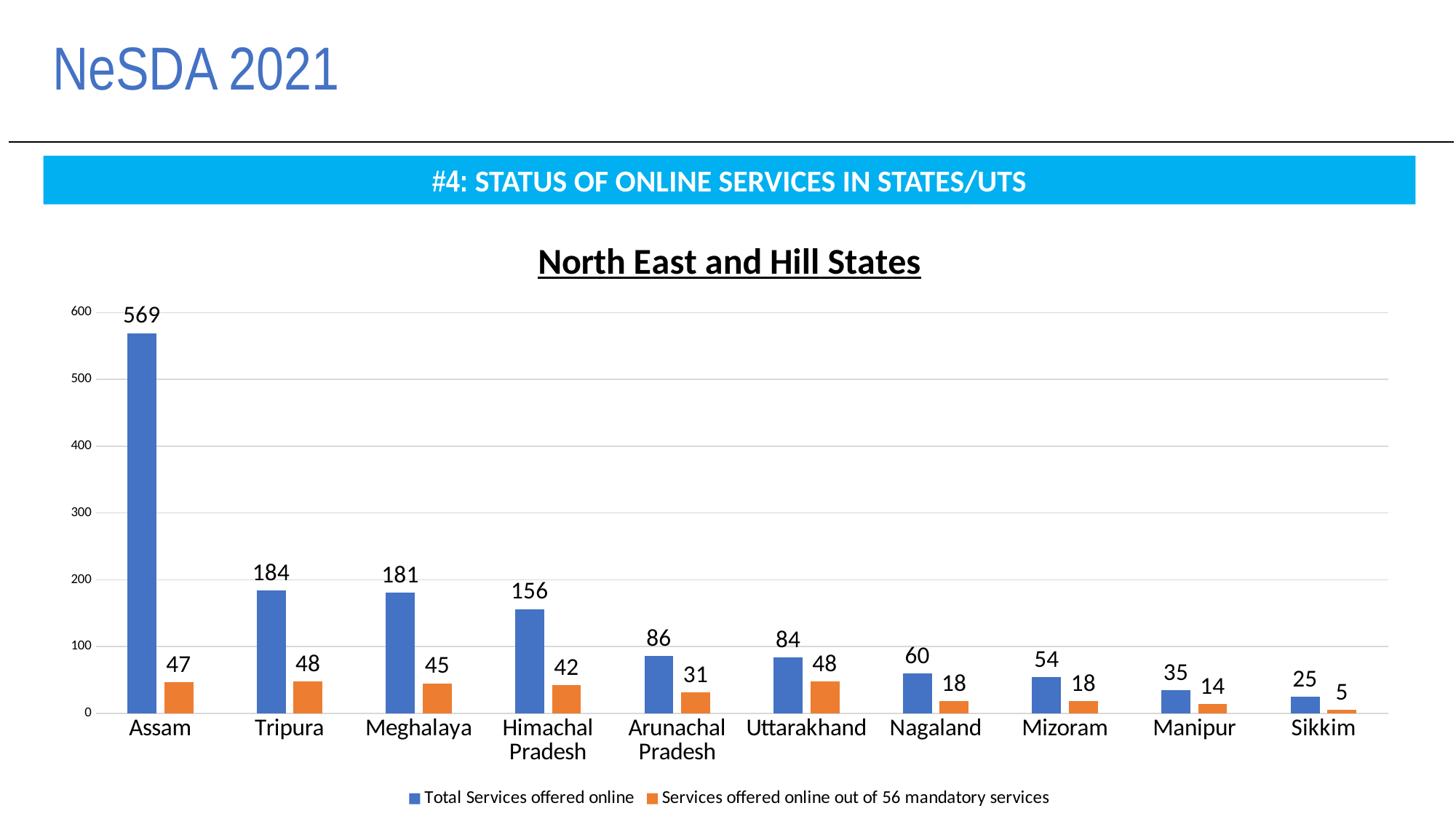
How many series does the legend list? 2 Which state has the lowest number of services offered online out of 56 mandatory services? Sikkim Is the value of Total Services offered online for Assam greater or less than 500? greater How many states are shown on the x axis of the chart? 10 Which state has the highest Total Services offered online? Assam What is the title of the chart? North East and Hill States What kind of chart is shown on the slide? Bar chart What is the value of Total Services offered online for Himachal Pradesh? 156 Which is larger: Total Services offered online for Arunachal Pradesh or for Uttarakhand? Arunachal Pradesh What is the difference between Total Services offered online for Tripura and Meghalaya? 3 What is the value of Total Services offered online for Assam? 569 How many services offered online out of 56 mandatory services does Tripura have? 48